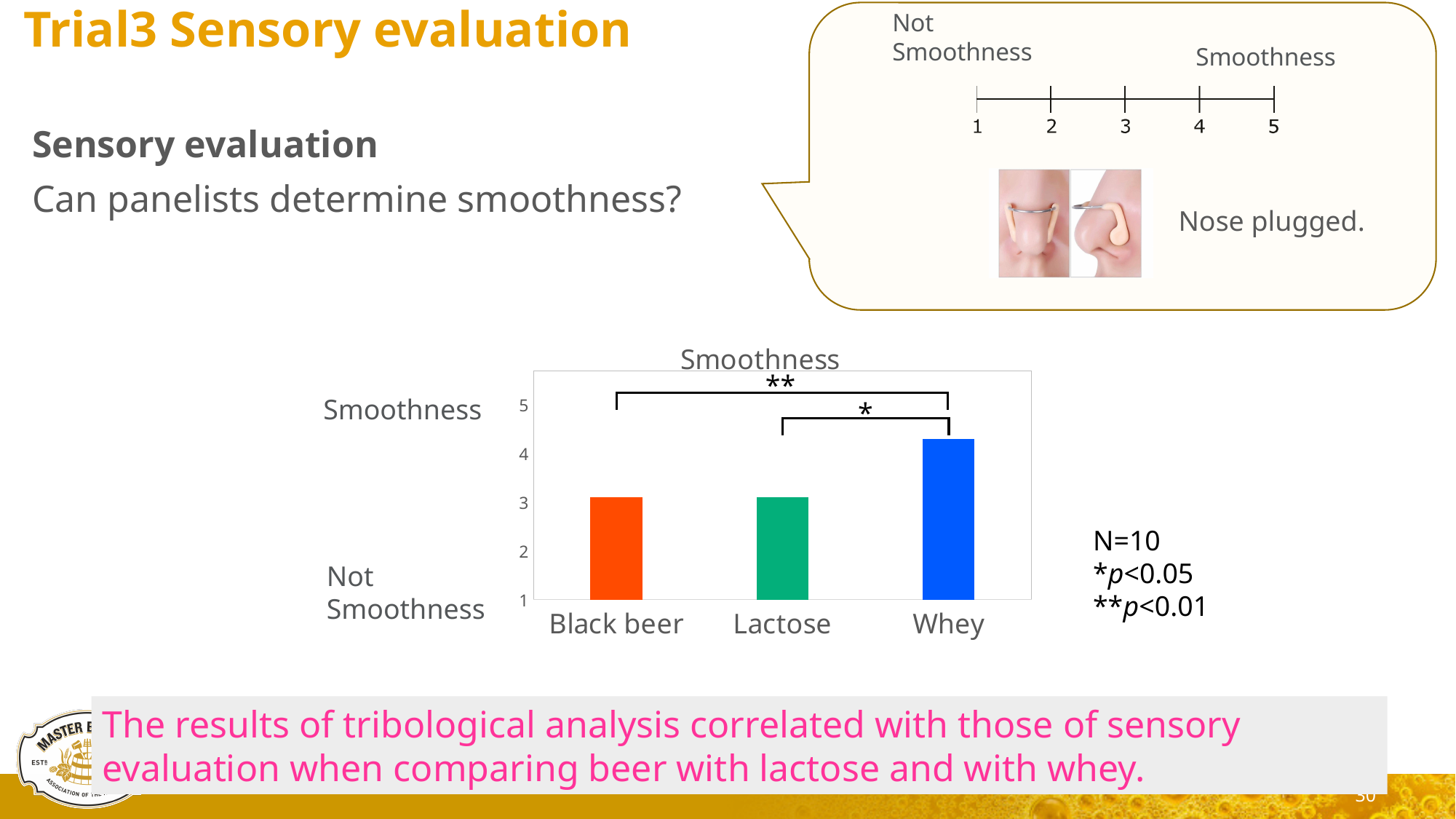
Is the smoothness value for Lactose greater or less than 4? less How many categories are plotted on the x axis of the chart? 3 What is the title of the chart? Smoothness What colour is the bar for Whey in the chart? blue Is the smoothness value for Black beer greater or less than 4? less Which has a higher smoothness score, Lactose or Whey? Whey Which category has the highest smoothness score in the chart? Whey What kind of chart is shown on the slide? bar chart Which has a higher smoothness score, Black beer or Whey? Whey Is the smoothness value for Whey greater or less than 5? less What is the highest value shown on the y axis of the chart? 5